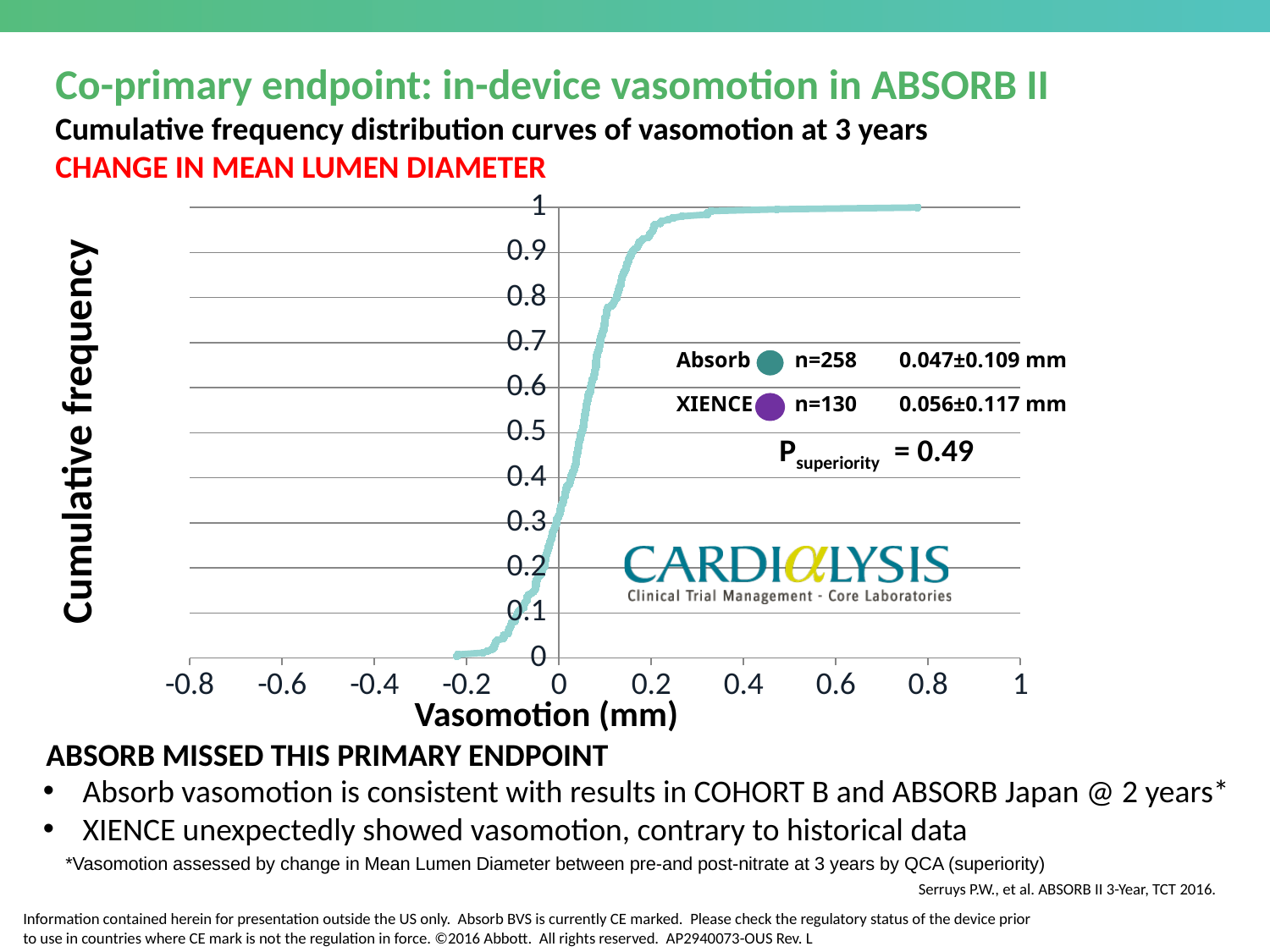
What is the P superiority value shown on the chart? 0.49 What mean vasomotion value is shown for XIENCE? 0.056±0.117 mm What kind of chart is shown on the slide? line chart What is the difference in n between Absorb and XIENCE? 128 Does the cumulative frequency curve rise or fall as vasomotion increases along the x axis? rise How many groups does the chart's legend list? 2 What is the n value shown for Absorb in the chart legend? n=258 Which group has the larger number of patients (n), Absorb or XIENCE? Absorb What is the label of the x axis of the chart? Vasomotion (mm) What mean vasomotion value is shown for Absorb? 0.047±0.109 mm What is the label of the y axis of the chart? Cumulative frequency What is the n value shown for XIENCE in the chart legend? n=130